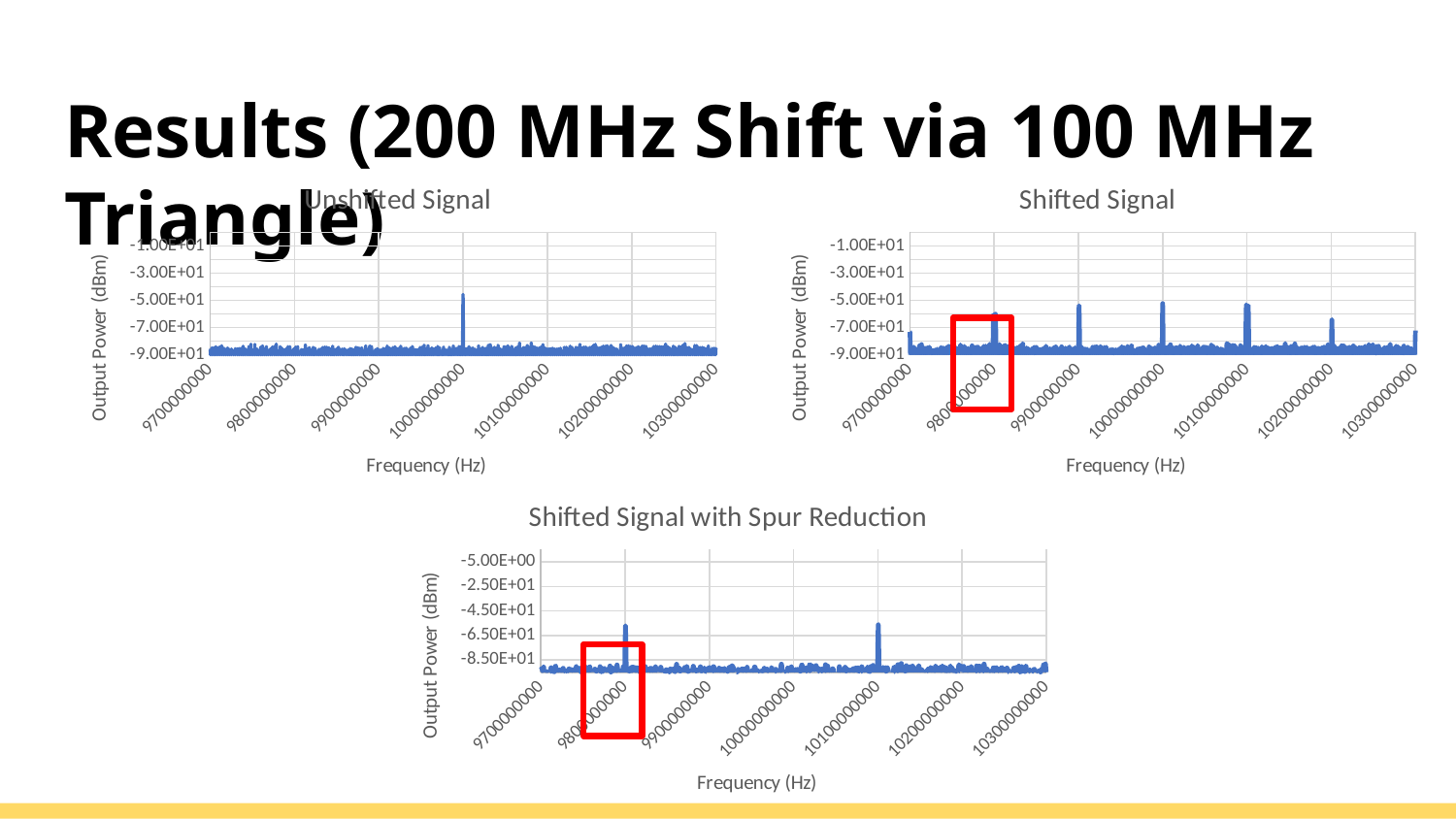
In the "Unshifted Signal" chart, what is the y-axis label? Output Power (dBm) In the "Shifted Signal with Spur Reduction" chart, what is the lowest labelled value on the y-axis? -8.50E+01 In the "Unshifted Signal" chart, is the noise floor level greater or less than -7.00E+01 dBm? less How many charts are shown on the slide? 3 In the "Unshifted Signal" chart, is the peak near 10000000000 Hz greater or less than -7.00E+01 dBm? greater In the "Shifted Signal with Spur Reduction" chart, is the peak near 10100000000 Hz greater or less than -8.50E+01 dBm? greater In the "Shifted Signal" chart, which peak is higher: the one near 10000000000 Hz or the one near 10200000000 Hz? 10000000000 Hz What kind of chart is the "Unshifted Signal" chart? line chart How many labelled frequency ticks are on the x-axis of the "Shifted Signal with Spur Reduction" chart? 7 What is the title of the chart at the bottom of the slide? Shifted Signal with Spur Reduction